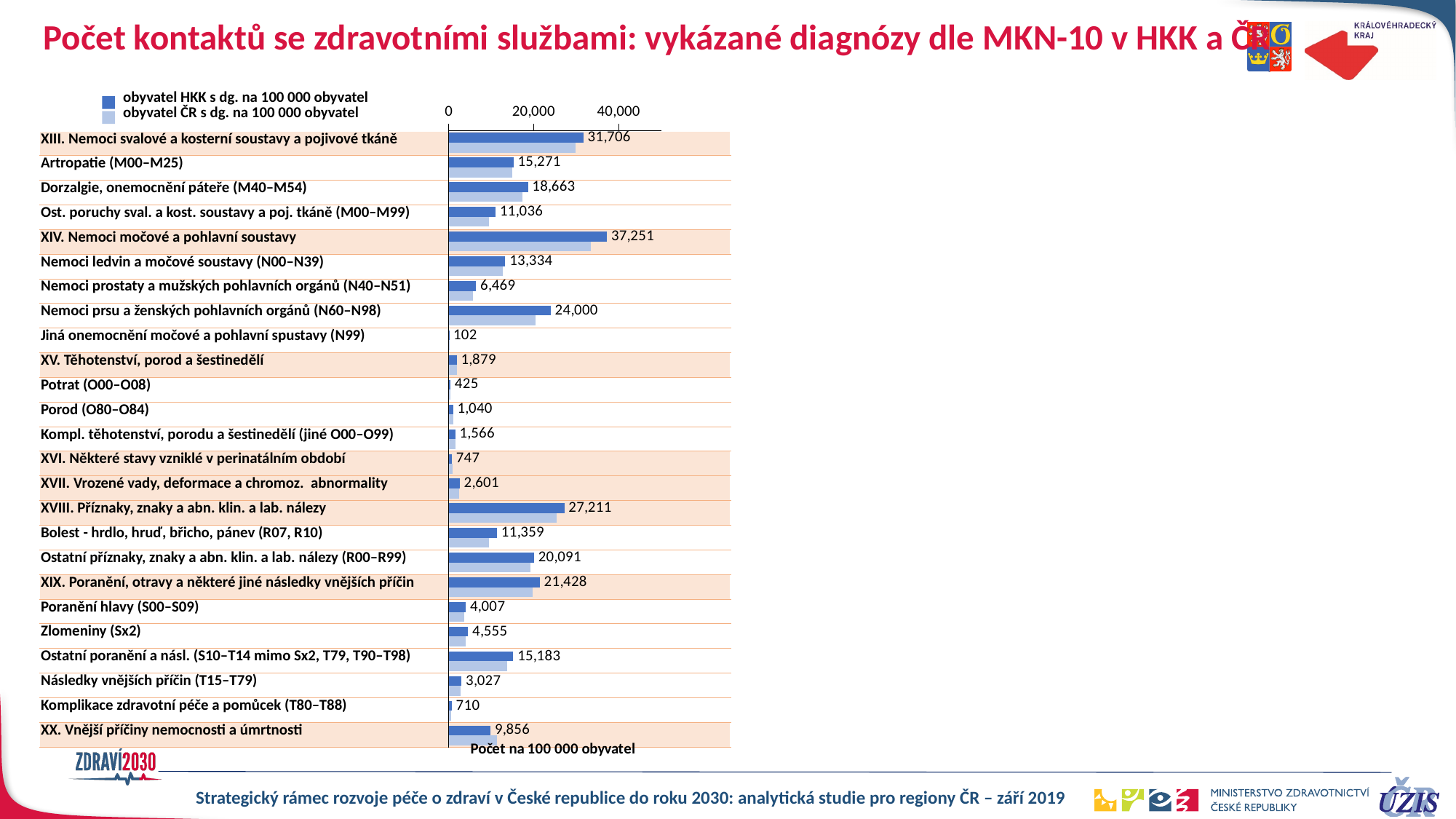
What is the axis label shown below the bars? Počet na 100 000 obyvatel Which category has the lowest HKK value? Jiná onemocnění močové a pohlavní spustavy (N99) What is the value for obyvatel HKK s dg. na 100 000 obyvatel for XIV. Nemoci močové a pohlavní soustavy? 37,251 What is the difference between the HKK values for XIV. Nemoci močové a pohlavní soustavy and XIII. Nemoci svalové a kosterní soustavy a pojivové tkáně? 5,545 Which has a larger HKK value, Zlomeniny (Sx2) or Poranění hlavy (S00–S09)? Zlomeniny (Sx2) How many categories are shown in the chart? 25 Which category has the highest HKK value? XIV. Nemoci močové a pohlavní soustavy What kind of chart is shown on the slide? bar chart How many series does the legend list? 2 What is the HKK value for Dorzalgie, onemocnění páteře (M40–M54)? 18,663 What is the HKK value for Nemoci prsu a ženských pohlavních orgánů (N60–N98)? 24,000 Is the value for obyvatel ČR s dg. na 100 000 obyvatel for XIV. Nemoci močové a pohlavní soustavy greater or less than 20,000? greater